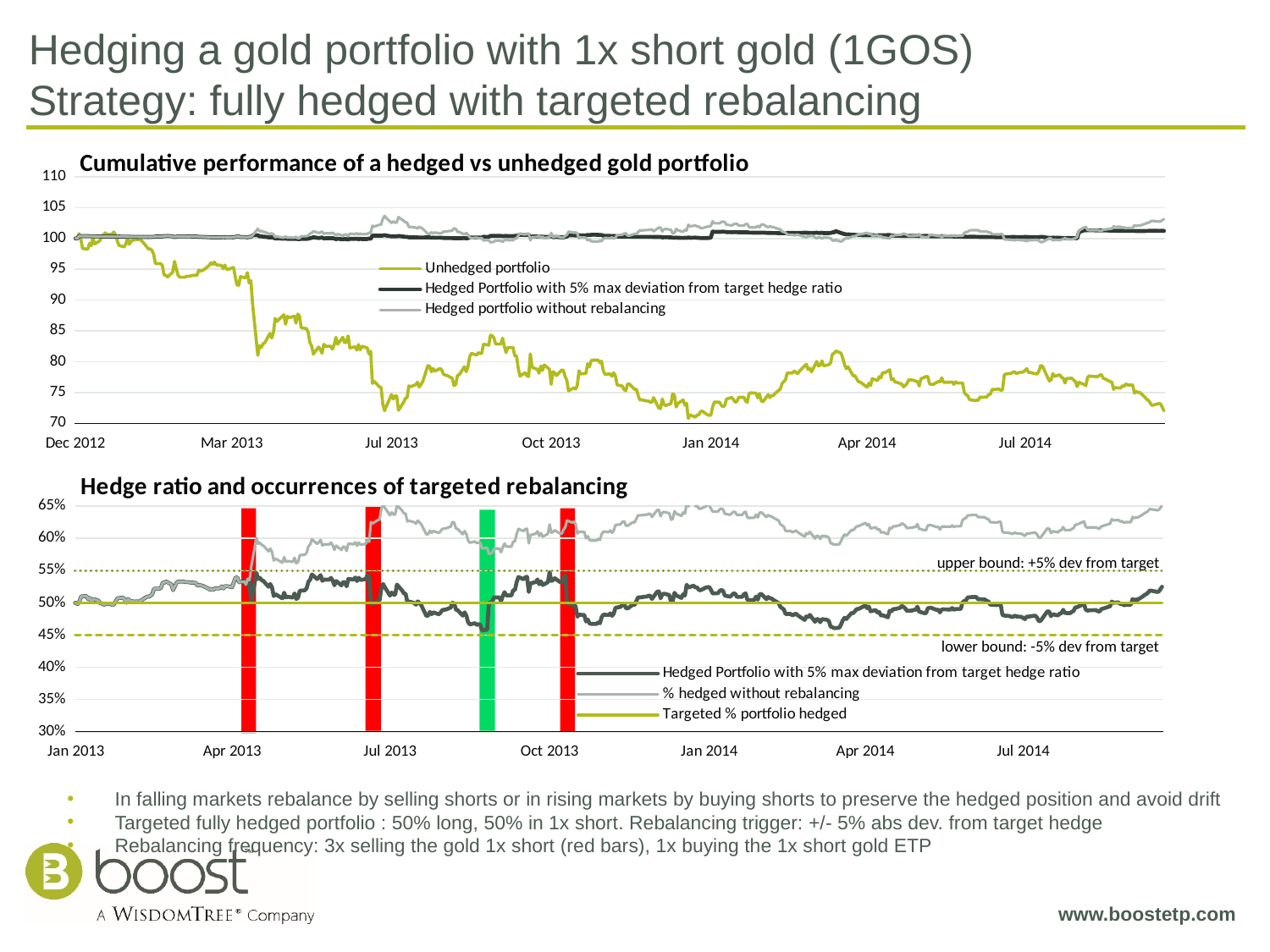
In the top chart, is the value of the Unhedged portfolio at Jan 2014 greater or less than 75? less In the top chart, does the Unhedged portfolio rise or fall between Dec 2012 and Jul 2013? fall What type of chart is the top chart titled 'Cumulative performance of a hedged vs unhedged gold portfolio'? line chart What is the title of the bottom chart? Hedge ratio and occurrences of targeted rebalancing In the bottom chart, at what level is the 'Targeted % portfolio hedged' line? 50% How many red bars are shown in the bottom chart? 3 In the top chart, which is larger at Jul 2013: the Unhedged portfolio or the Hedged portfolio without rebalancing? Hedged portfolio without rebalancing In the bottom chart, at what level is the upper bound line (+5% dev from target)? 55% How many series does the legend of the top chart list? 3 In the top chart, is the value of the Hedged portfolio without rebalancing at Jul 2013 greater or less than 100? greater In the top chart, which series is lowest across most of the period shown? Unhedged portfolio